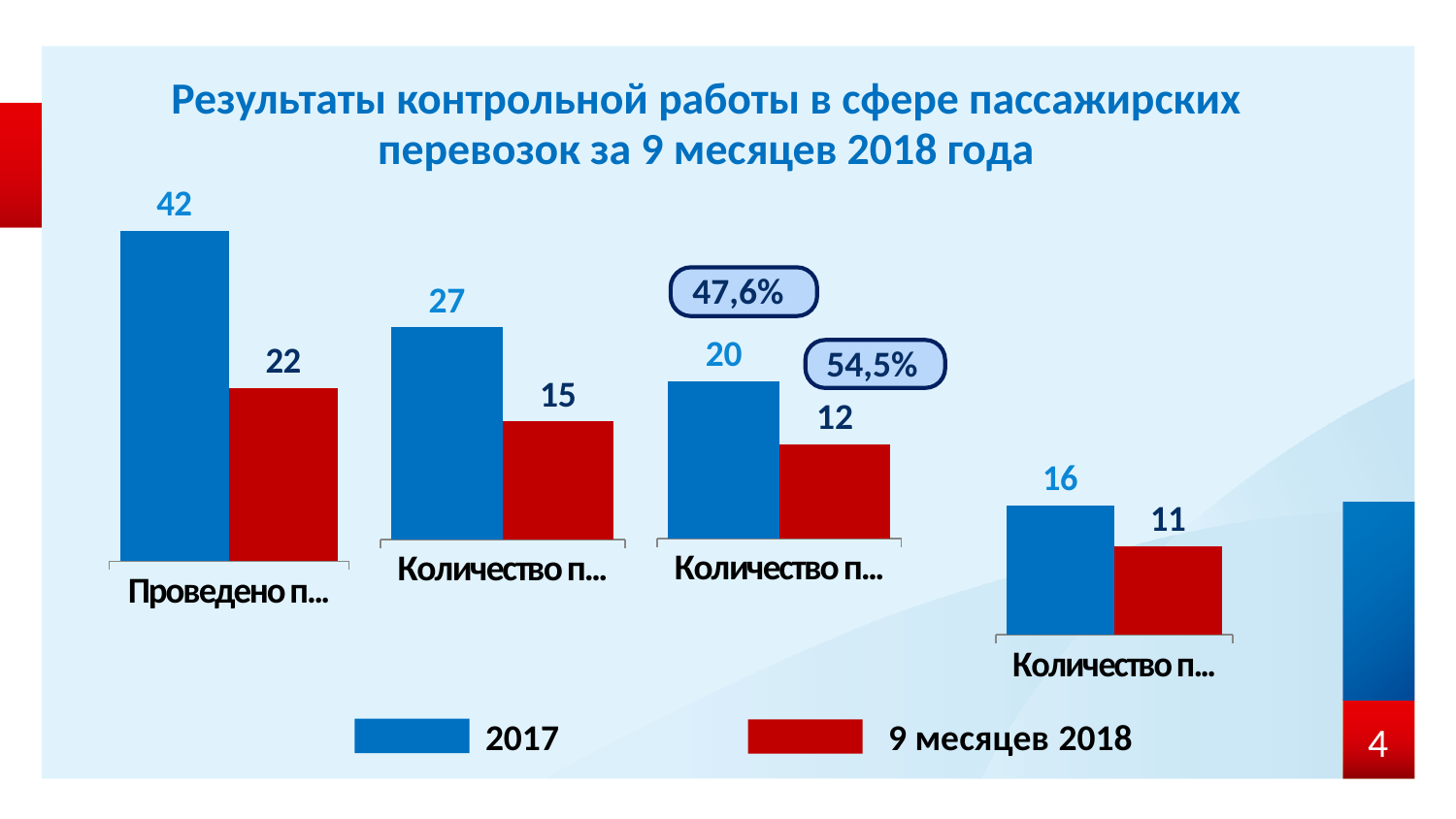
What are the two series named in the legend? 2017 and 9 месяцев 2018 What is the 9 месяцев 2018 value for the fourth (rightmost) category group? 11 How many series does the legend list? 2 What is the 9 месяцев 2018 value for the first (leftmost) category group? 22 What is the 2017 value for the second category group from the left? 27 What is the difference between the 2017 and 9 месяцев 2018 values in the third category group from the left? 8 How many category groups of bars are plotted? 4 What is the 2017 value for the first (leftmost) category group? 42 Which is larger in the second category group from the left: the 2017 value or the 9 месяцев 2018 value? 2017 Which category group has the lowest 9 месяцев 2018 value? the fourth (rightmost) group What kind of chart is shown on the slide? bar chart Which category group has the highest 2017 value? the first (leftmost) group